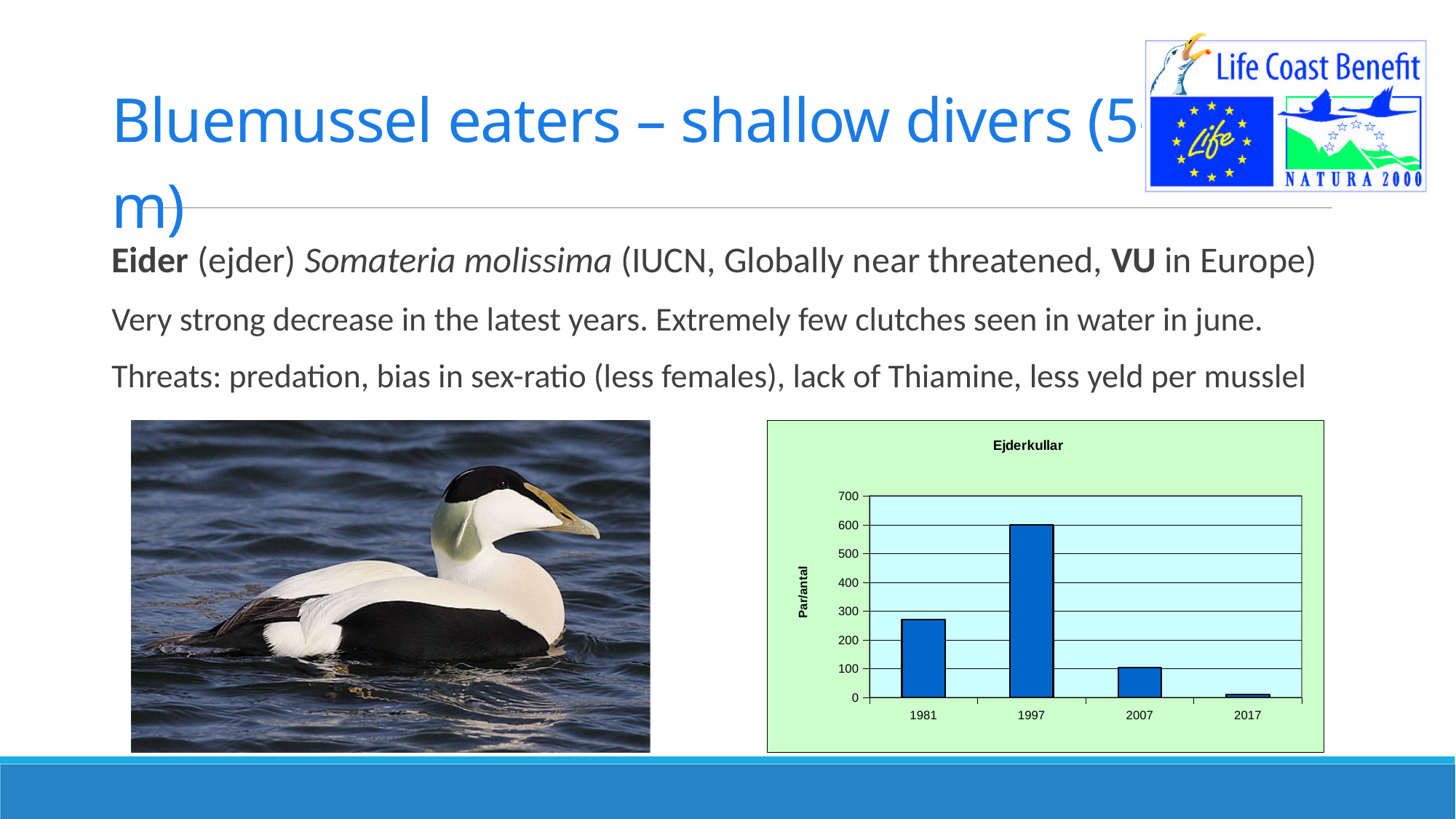
Is the value for 2007 in the Ejderkullar chart greater or less than 200? less How many years are shown on the x axis of the Ejderkullar chart? 4 Is the value for 2017 in the Ejderkullar chart greater or less than 100? less What is the label on the y axis of the Ejderkullar chart? Par/antal Which year has the highest value in the Ejderkullar chart? 1997 Is the value for 1997 in the Ejderkullar chart greater or less than 500? greater Do the values in the Ejderkullar chart rise or fall from 1997 to 2017? fall What kind of chart is shown on the slide? bar chart Which is larger in the Ejderkullar chart, the value for 1981 or the value for 2007? 1981 Which year has the lowest value in the Ejderkullar chart? 2017